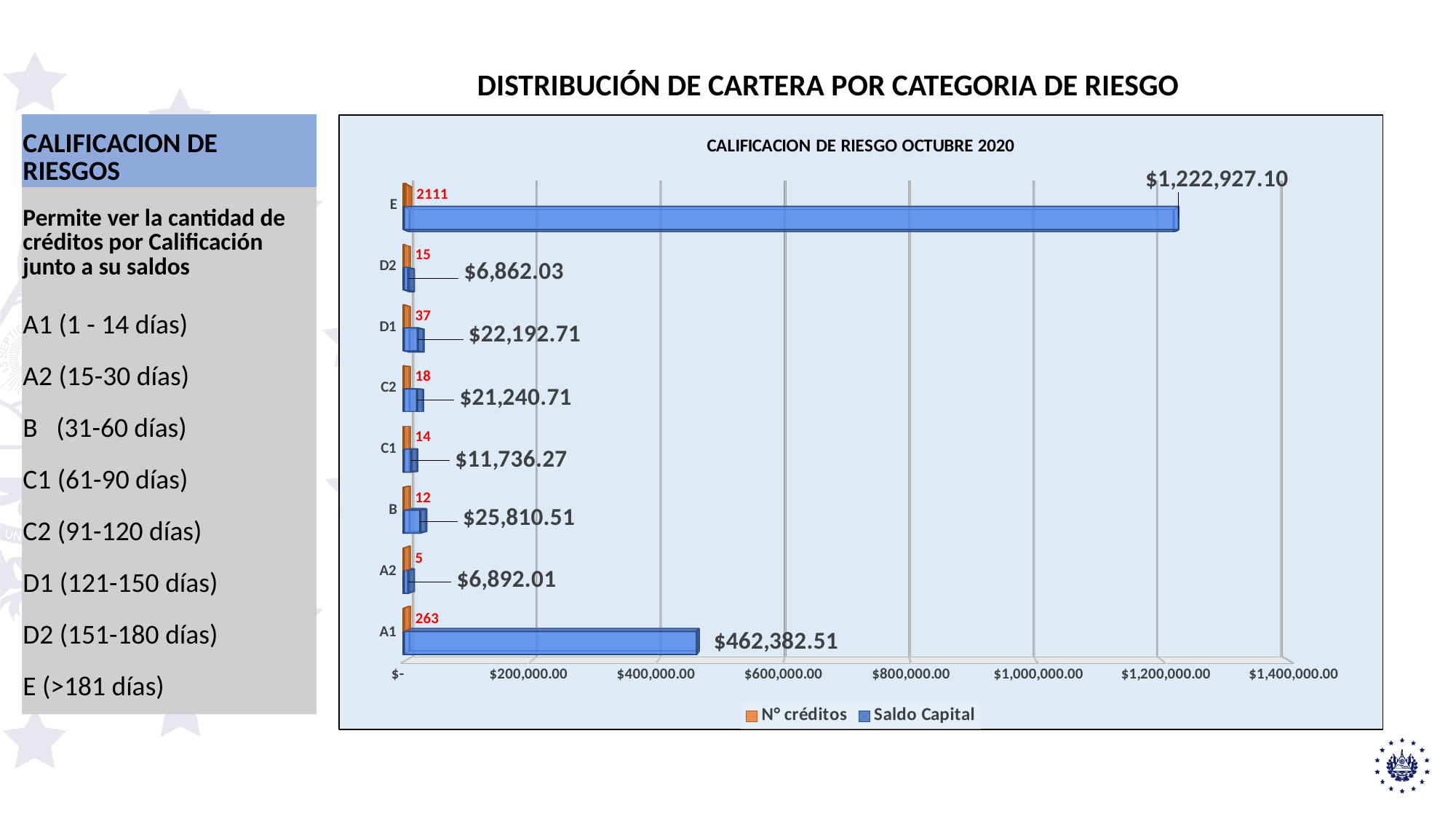
What is the difference in Saldo Capital between E and A1? $760,544.59 What is the Saldo Capital value for category E? $1,222,927.10 What is the Nº créditos value for category D1? 37 What is the Saldo Capital value for category B? $25,810.51 What kind of chart is shown? bar chart What is the Nº créditos value for category A1? 263 How many series does the legend list? 2 Which category has the lowest Nº créditos? A2 Is the Saldo Capital for A1 greater or less than $400,000.00? greater Which has a larger Saldo Capital, D1 or C2? D1 How many categories are shown on the chart? 8 Which category has the highest Saldo Capital? E